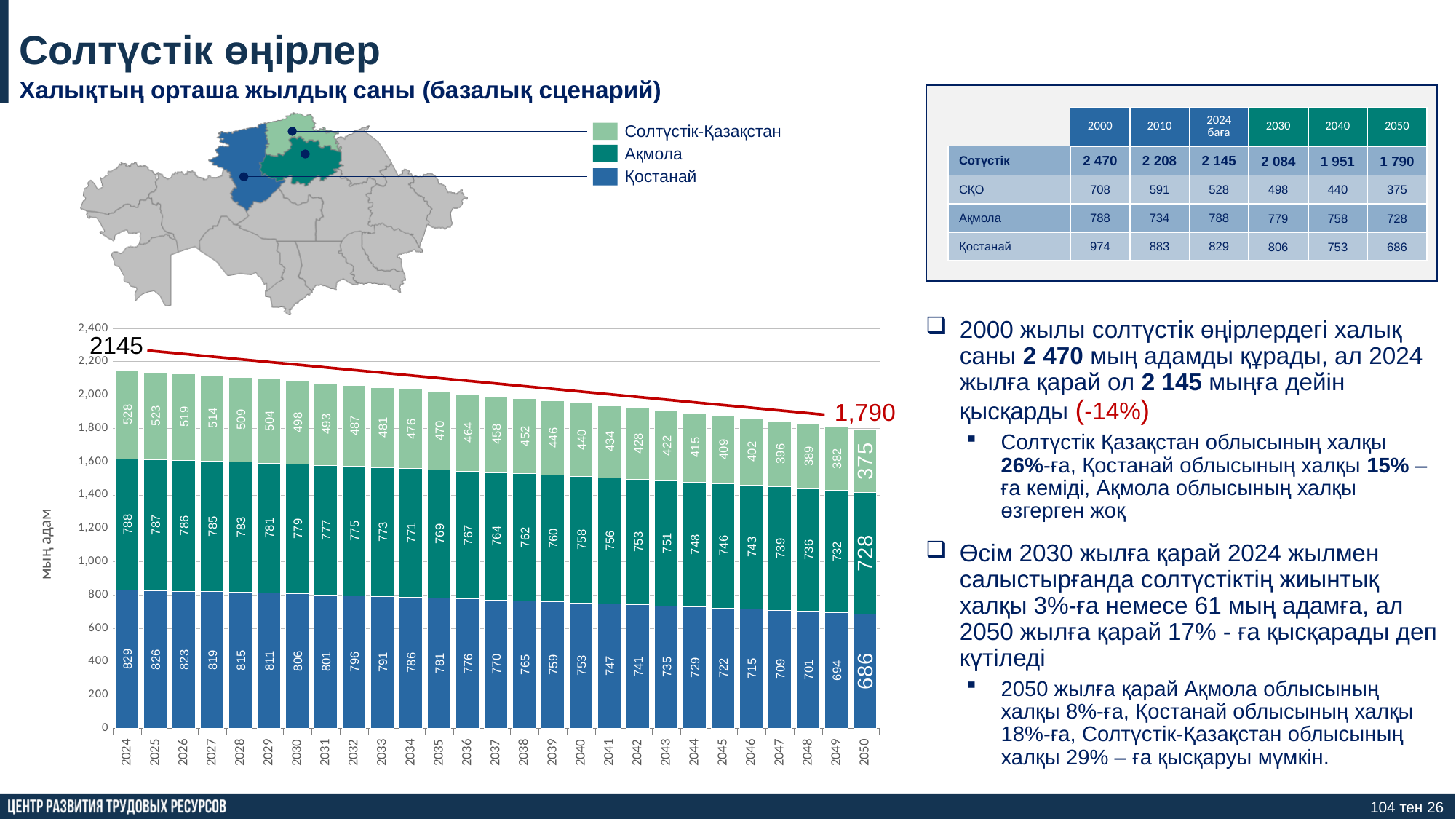
What is the total of the stacked bar for 2024? 2145 What is the difference between the Қостанай values for 2024 and 2050? 143 Do the total bar heights rise or fall from 2024 to 2050? Fall Which series has the largest value in 2024? Қостанай How many years are plotted along the x axis of the chart? 27 What is the value for Қостанай in 2035? 781 What kind of chart is shown on the slide? Stacked bar chart with a line What is the value for Солтүстік-Қазақстан in 2030? 498 Which series has the smallest value in 2050? Солтүстік-Қазақстан How many series does the chart's legend list? 3 In 2050, which is larger: the value for Ақмола or the value for Қостанай? Ақмола What is the value for Ақмола in 2040? 758